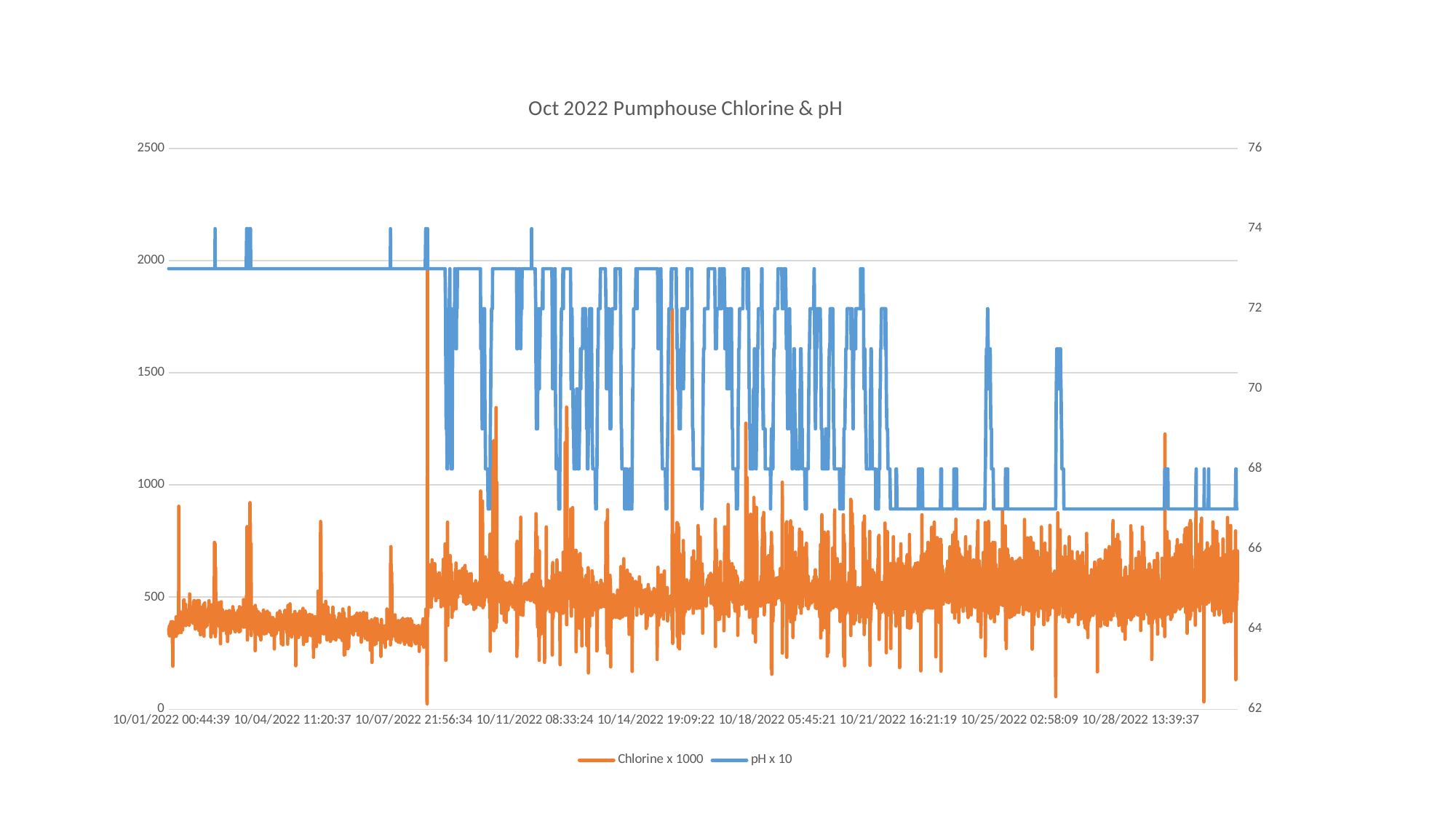
Does the Chlorine x 1000 series generally rise or fall from the start of October to the end of October? Rise Is the pH x 10 value higher at the start of October or at the end of October? Start of October Is the pH x 10 value at the start of October greater or less than 72? greater Does the pH x 10 series generally rise or fall from the start of October to the end of October? Fall Which series is drawn in blue? pH x 10 Is the highest spike of the Chlorine x 1000 series greater or less than 1500? greater Is the Chlorine x 1000 level higher around 10/04/2022 or around 10/28/2022? 10/28/2022 How many series does the legend list? 2 Is the pH x 10 value at the end of October greater or less than 70? less What kind of chart is shown on the slide? Line chart What is the title of the chart? Oct 2022 Pumphouse Chlorine & pH